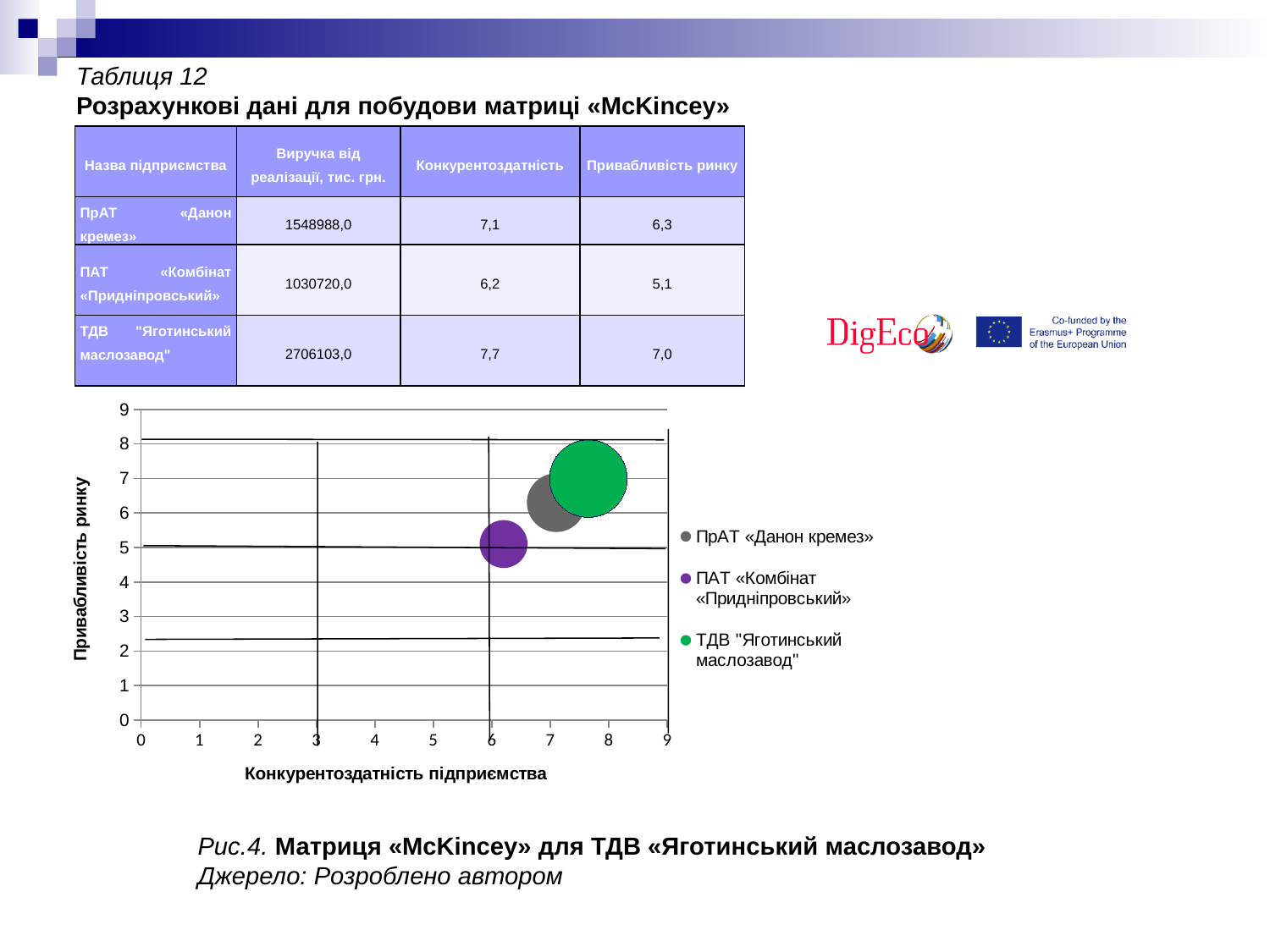
Is the market attractiveness value for ПАТ «Комбінат «Придніпровський» greater or less than 6? less What kind of chart is shown on the slide? bubble chart How many series does the chart legend list? 3 Is the competitiveness value for ТДВ "Яготинський маслозавод" greater or less than 7? greater Which has the higher competitiveness value: ПрАТ «Данон кремез» or ПАТ «Комбінат «Придніпровський»? ПрАТ «Данон кремез» Which company has the lowest competitiveness (Конкурентоздатність) on the chart? ПАТ «Комбінат «Придніпровський» What is the title of the horizontal axis of the chart? Конкурентоздатність підприємства According to the table, what is the competitiveness value plotted for ПрАТ «Данон кремез»? 7,1 Which company has the highest market attractiveness (Привабливість ринку) on the chart? ТДВ "Яготинський маслозавод" How many bubbles are plotted on the chart? 3 Which company is represented by the green bubble in the chart? ТДВ "Яготинський маслозавод" Using the table values, what is the difference in competitiveness between ТДВ "Яготинський маслозавод" and ПАТ «Комбінат «Придніпровський»? 1,5